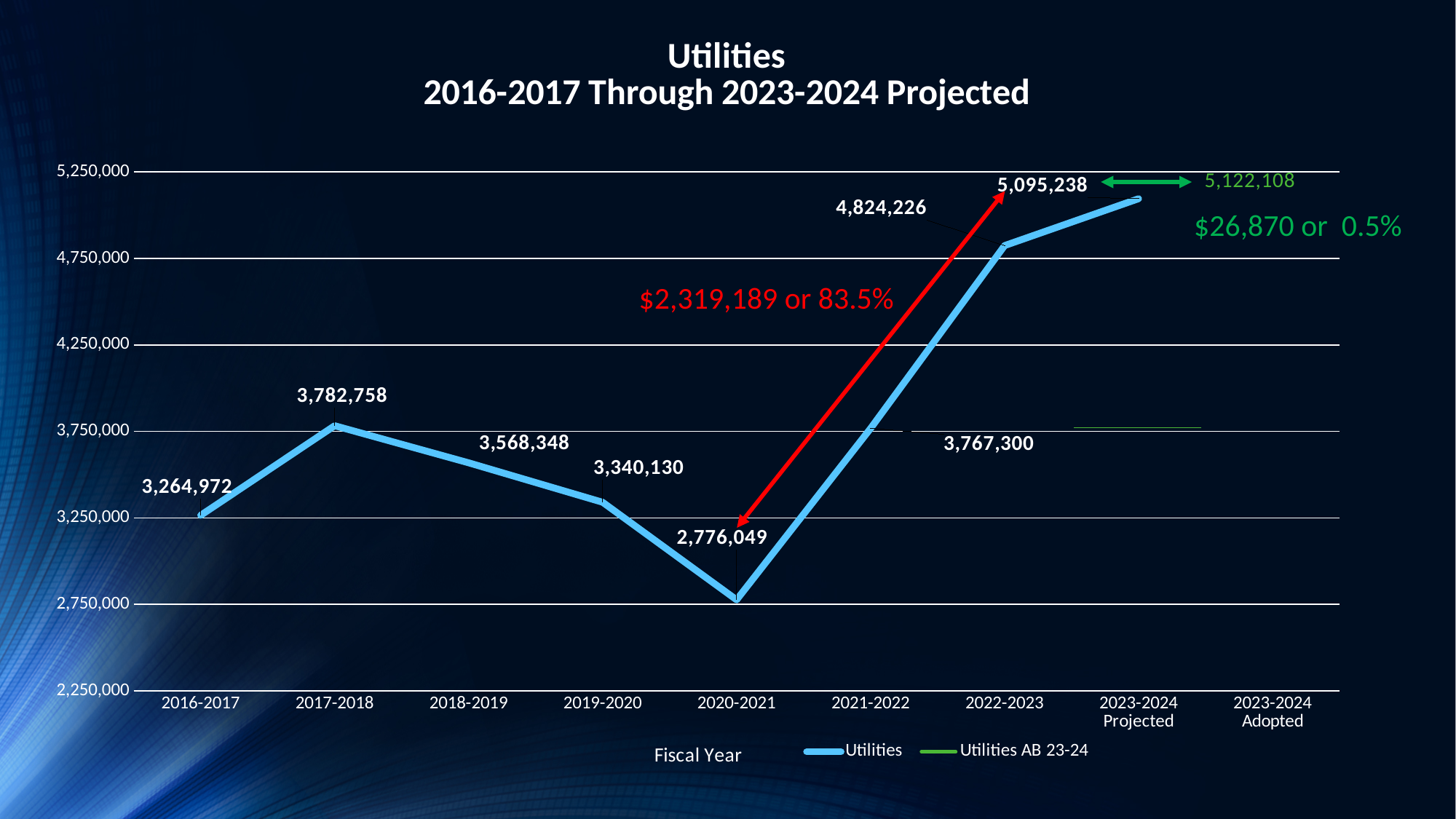
What value is shown for 2023-2024 Adopted (Utilities AB 23-24)? 5,122,108 Is the Utilities value for 2022-2023 greater or less than 4,750,000? greater How many series does the legend list? 2 Which fiscal year has the larger Utilities value, 2018-2019 or 2019-2020? 2018-2019 What is the Utilities value for fiscal year 2017-2018? 3,782,758 Do the Utilities values rise or fall from 2017-2018 to 2020-2021? fall What is the Utilities value for fiscal year 2020-2021? 2,776,049 Which fiscal year has the lowest Utilities value? 2020-2021 What kind of chart is shown on the slide? line chart What is the difference between the Utilities values for 2017-2018 and 2016-2017? 517,786 What is the difference between the Utilities values for 2022-2023 and 2021-2022? 1,056,926 Which fiscal year has the highest value on the Utilities line? 2023-2024 Projected